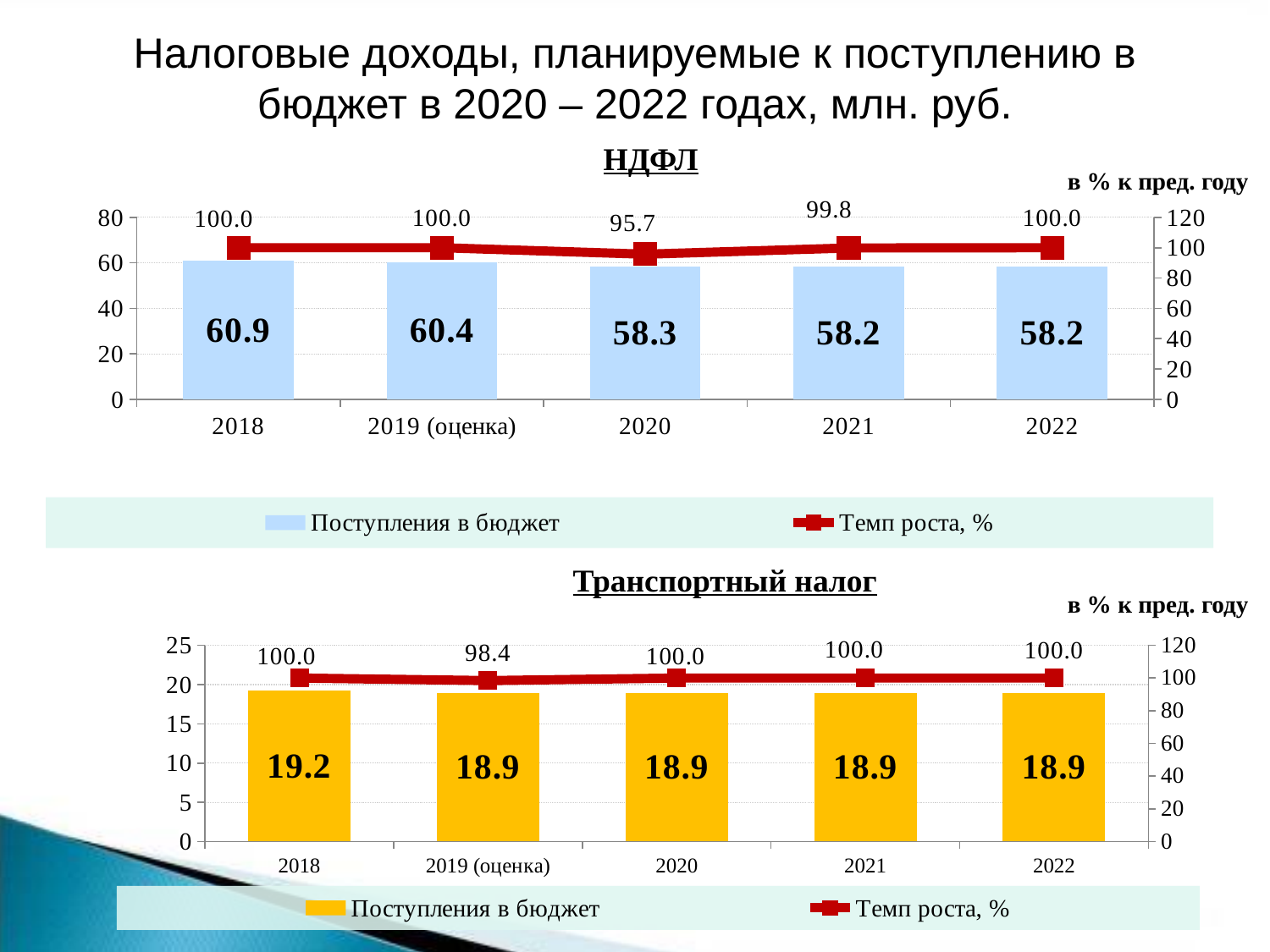
In the Транспортный налог chart, how many years are shown on the x axis? 5 In the Транспортный налог chart, what is the Темп роста, % value for 2019 (оценка)? 98.4 In the Транспортный налог chart, which year has the lowest Темп роста, % value? 2019 (оценка) In the НДФЛ chart, which year has the lowest Темп роста, % value? 2020 In the НДФЛ chart, do the Поступления в бюджет values rise or fall from 2018 to 2022? fall In the НДФЛ chart, is the Поступления в бюджет value for 2021 larger or smaller than the value for 2019 (оценка)? smaller In the НДФЛ chart, what is the difference between the Поступления в бюджет values for 2018 and 2020? 2.6 In the НДФЛ chart, which year has the highest Поступления в бюджет value? 2018 In the НДФЛ chart, what is the Темп роста, % value for 2020? 95.7 In the Транспортный налог chart, what is the value of Поступления в бюджет for 2018? 19.2 In the Транспортный налог chart, how many series does the legend list? 2 In the НДФЛ chart, what is the value of Поступления в бюджет for 2018? 60.9